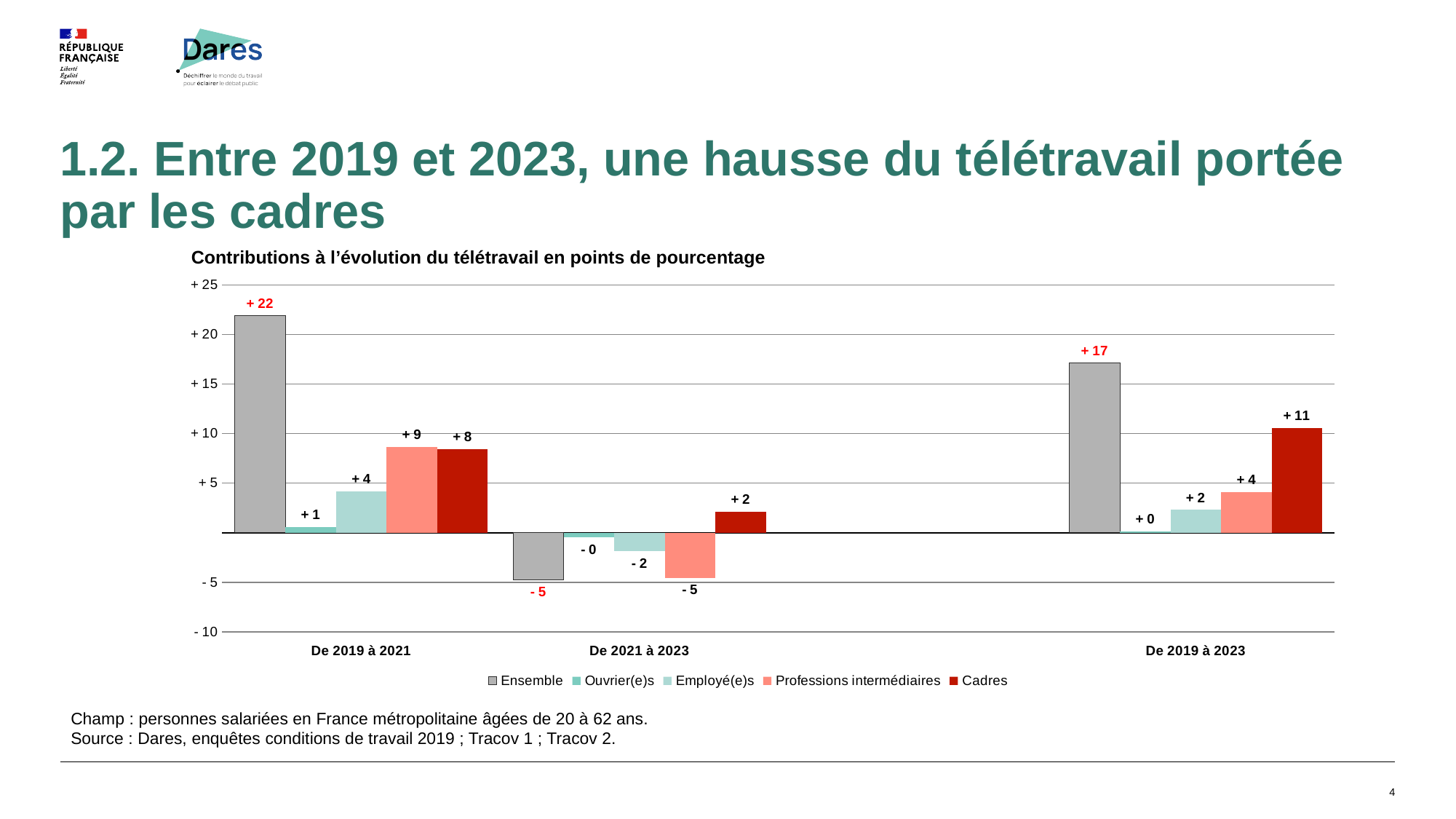
Which series has the lowest value in the period De 2019 à 2021? Ouvrier(e)s In the period De 2019 à 2023, which is larger: the value for Cadres or the value for Professions intermédiaires? Cadres What is the value for Employé(e)s in the period De 2019 à 2021? + 4 What is the difference between the Ensemble values for De 2019 à 2021 and De 2019 à 2023? 5 What is the title of the chart? Contributions à l'évolution du télétravail en points de pourcentage How many series does the legend list? 5 What is the value for Ensemble in the period De 2019 à 2021? + 22 What kind of chart is shown on the slide? Bar chart What is the value for Professions intermédiaires in the period De 2021 à 2023? - 5 What is the value for Cadres in the period De 2019 à 2023? + 11 Which series has the highest value in the period De 2019 à 2023? Ensemble How many periods are shown on the x axis? 3